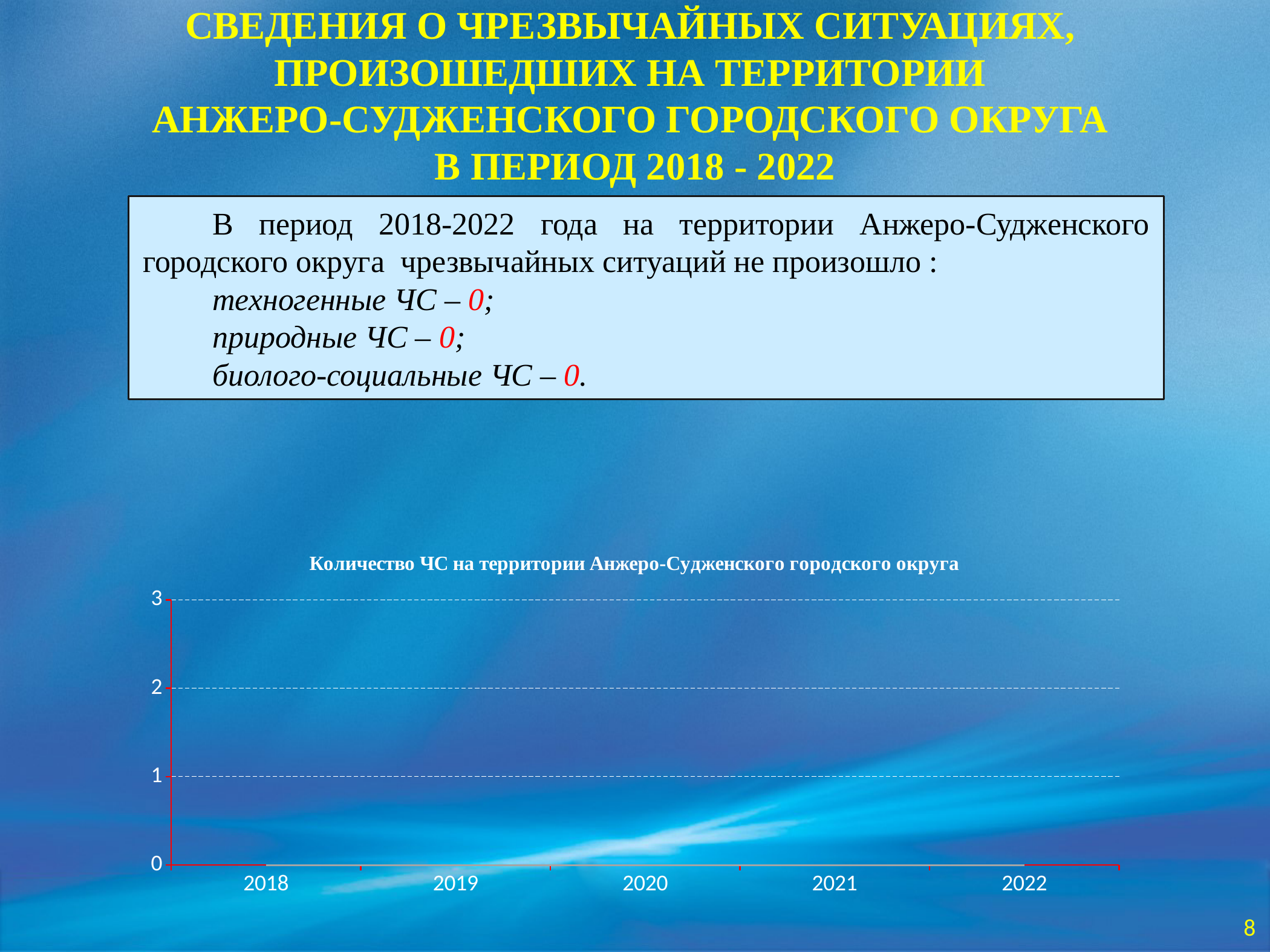
What is the highest tick value shown on the y axis of the chart? 3 What is the first year shown on the x axis of the chart? 2018 What is the last year shown on the x axis of the chart? 2022 What is the title of the chart? Количество ЧС на территории Анжеро-Судженского городского округа Is the value for 2020 greater or less than 1? less Is the value for 2018 greater or less than 1? less Is the value for 2022 greater or less than 2? less How many years are shown on the x axis of the chart? 5